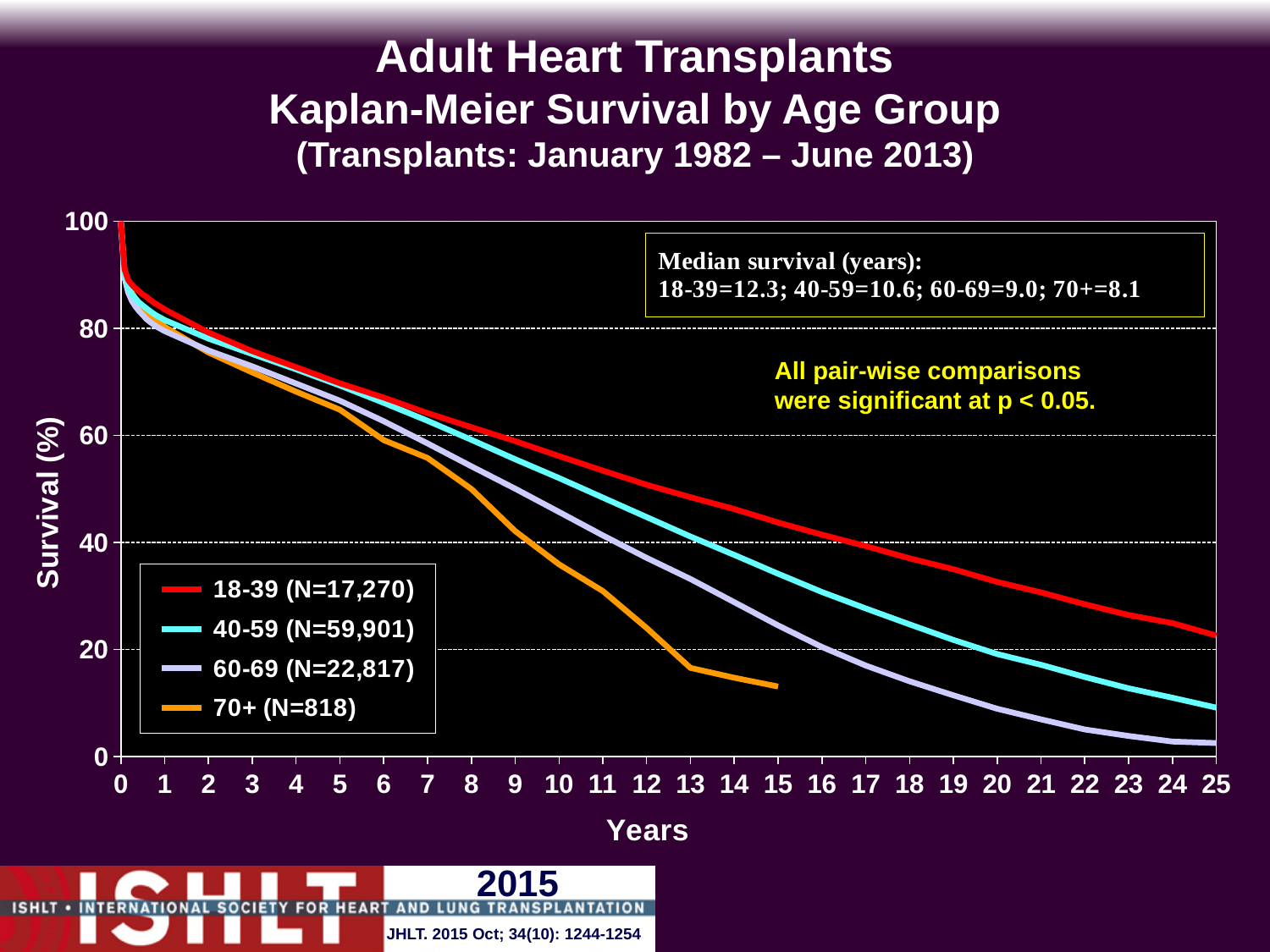
What is the median survival in years for the 60-69 age group? 9.0 What is the difference in median survival (years) between the 18-39 and 70+ age groups? 4.2 At 10 years, which group has higher survival, 18-39 or 70+? 18-39 What kind of chart is shown on the slide? line chart Which age group has the highest median survival? 18-39 What is the median survival in years for the 18-39 age group? 12.3 What colour is the line for the 70+ age group? orange How many patients (N) are in the 40-59 age group? 59,901 How many age groups (series) does the legend list? 4 Is the survival for the 60-69 group at 25 years greater or less than 20%? less Which age group has the lowest median survival? 70+ Do the survival curves rise or fall as years increase? fall